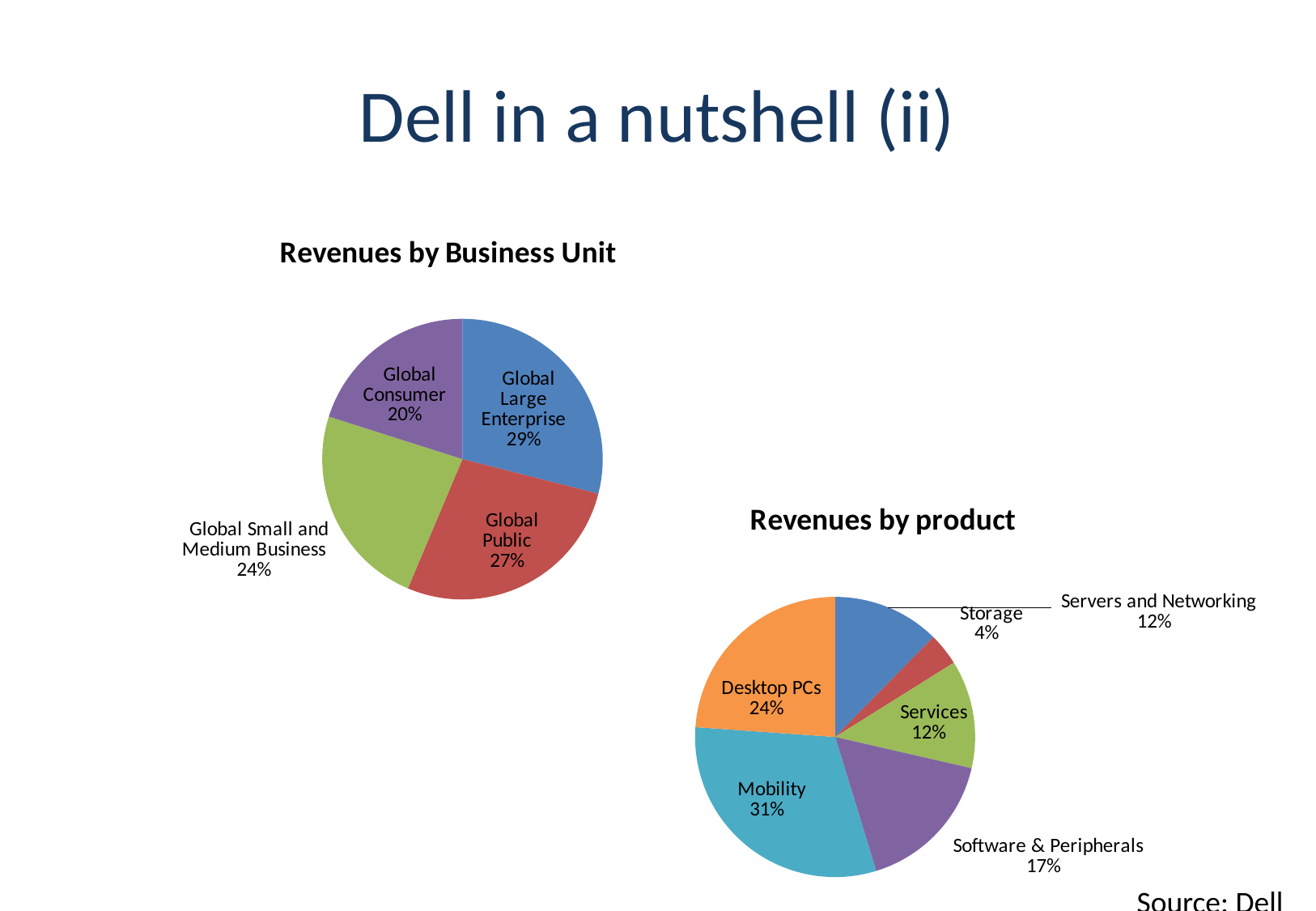
In the 'Revenues by product' chart, what share of revenue comes from Mobility? 31% In the 'Revenues by Business Unit' chart, which business unit has the largest share? Global Large Enterprise In the 'Revenues by Business Unit' chart, what share of revenue comes from Global Large Enterprise? 29% What type of chart is used for 'Revenues by product'? Pie chart In the 'Revenues by product' chart, which product category has the largest share? Mobility In the 'Revenues by product' chart, which is larger: Desktop PCs or Software & Peripherals? Desktop PCs In the 'Revenues by Business Unit' chart, how many business units are shown? 4 In the 'Revenues by Business Unit' chart, which business unit has the smallest share? Global Consumer In the 'Revenues by product' chart, how many product categories are shown? 6 In the 'Revenues by product' chart, what share of revenue comes from Storage? 4% In the 'Revenues by Business Unit' chart, what share of revenue comes from Global Small and Medium Business? 24% In the 'Revenues by Business Unit' chart, what is the difference between the Global Public and Global Consumer shares? 7%